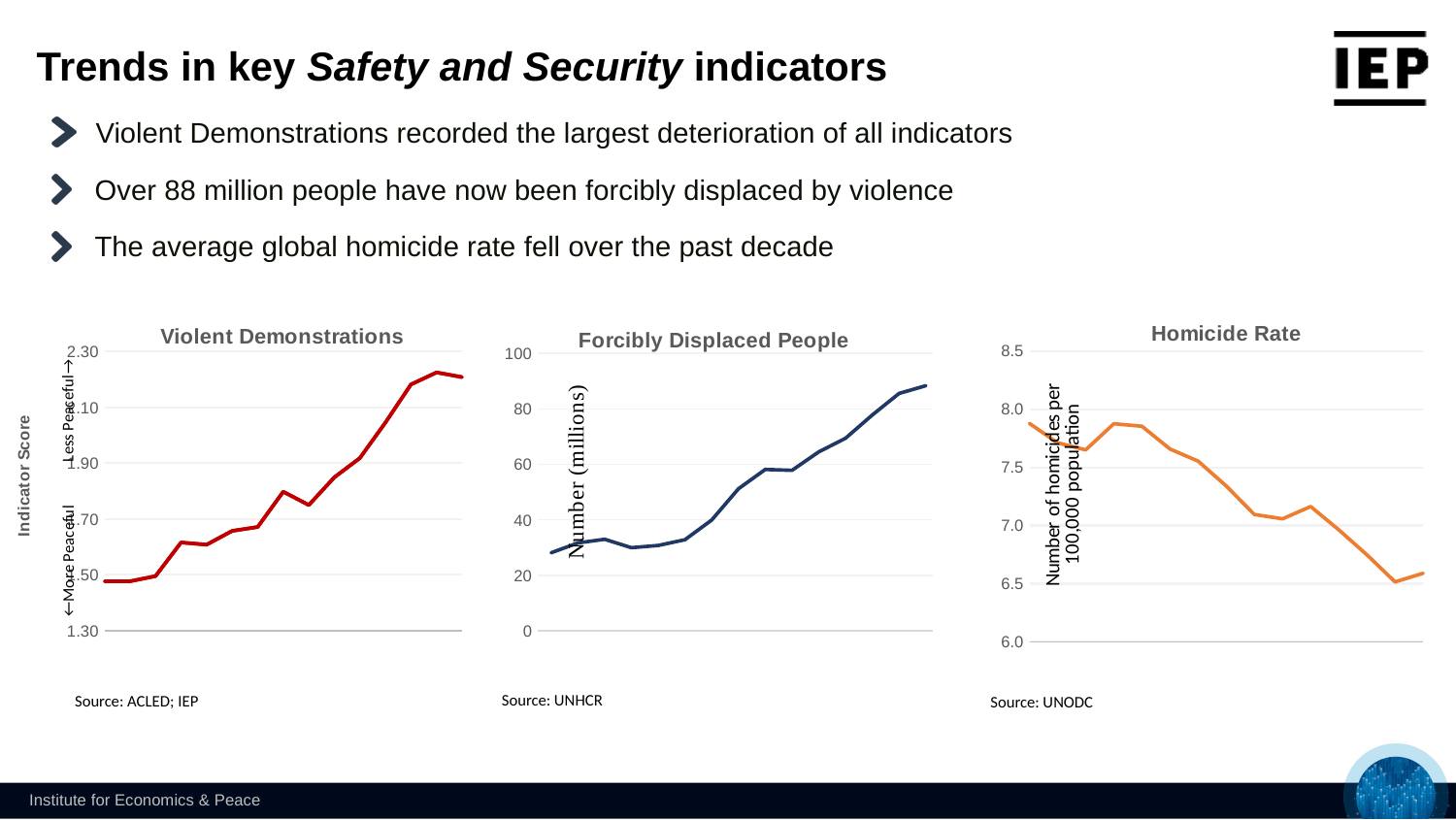
In the Homicide Rate chart, do the values generally rise or fall along the x axis? Fall In the Homicide Rate chart, is the first value greater or less than 7.5? greater How many charts are shown on the slide? 3 In the Violent Demonstrations chart, is the final value greater or less than 2.10? greater What is the y-axis label of the Forcibly Displaced People chart? Number (millions) In the Forcibly Displaced People chart, do the values generally rise or fall along the x axis? Rise What kind of chart is the Violent Demonstrations chart? Line chart In the Violent Demonstrations chart, do the values generally rise or fall along the x axis? Rise In the Homicide Rate chart, is the final value greater or less than 7.0? less